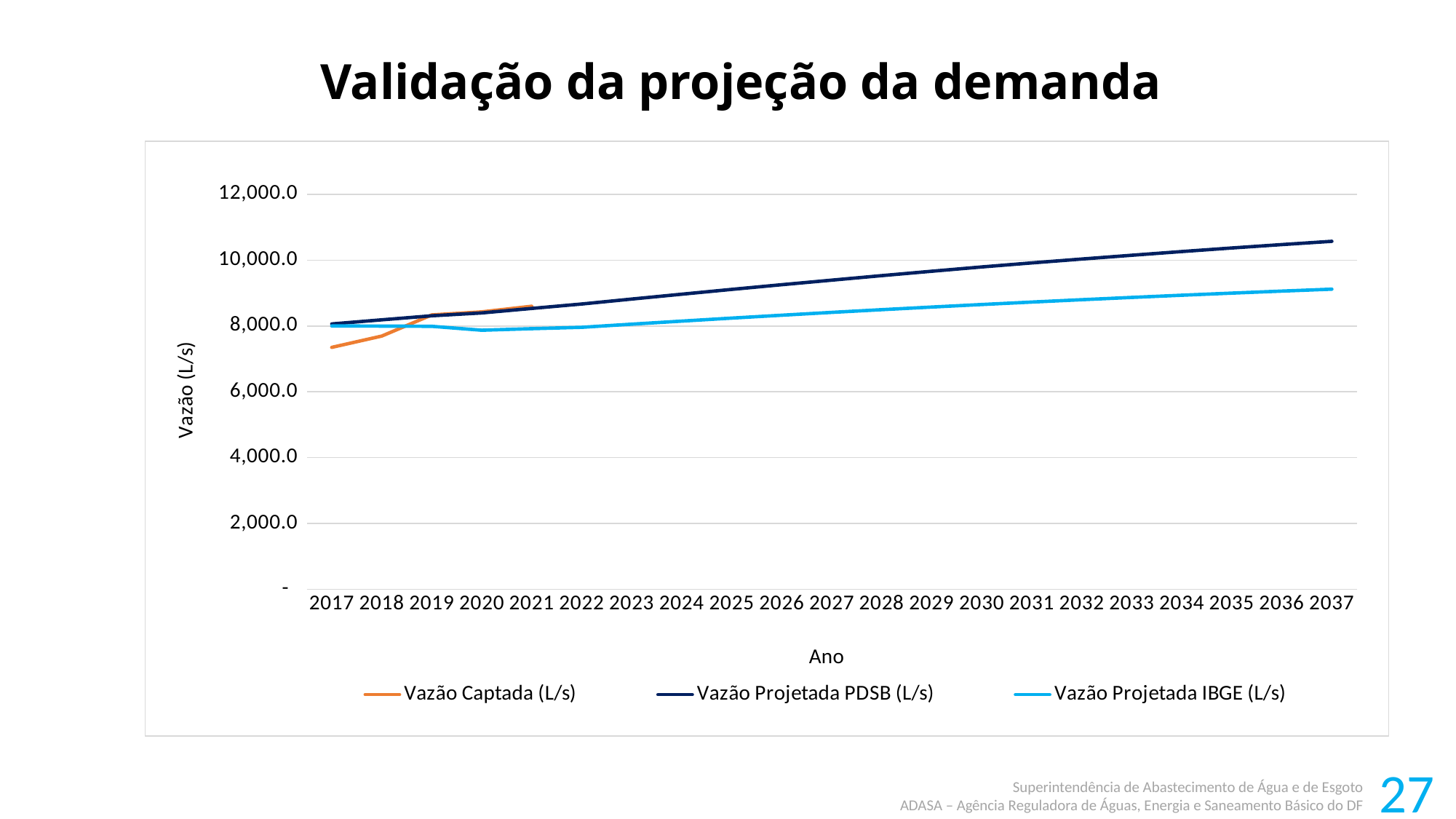
What is the title of the slide's chart area? Validação da projeção da demanda What kind of chart is shown on the slide? line chart Is the value for Vazão Captada (L/s) in 2017 greater or less than 8,000.0? less How many series does the legend list? 3 Is the value for Vazão Projetada PDSB (L/s) in 2037 greater or less than 10,000.0? greater Does the Vazão Projetada PDSB (L/s) series rise or fall from 2017 to 2037? rise What is the label of the y axis? Vazão (L/s) Which series has the highest value in 2037? Vazão Projetada PDSB (L/s) Which series has the higher value in 2037, Vazão Projetada PDSB (L/s) or Vazão Projetada IBGE (L/s)? Vazão Projetada PDSB (L/s) Which series has the higher value in 2017, Vazão Captada (L/s) or Vazão Projetada PDSB (L/s)? Vazão Projetada PDSB (L/s) How many years are shown on the x axis? 21 Is the value for Vazão Projetada IBGE (L/s) in 2037 greater or less than 10,000.0? less